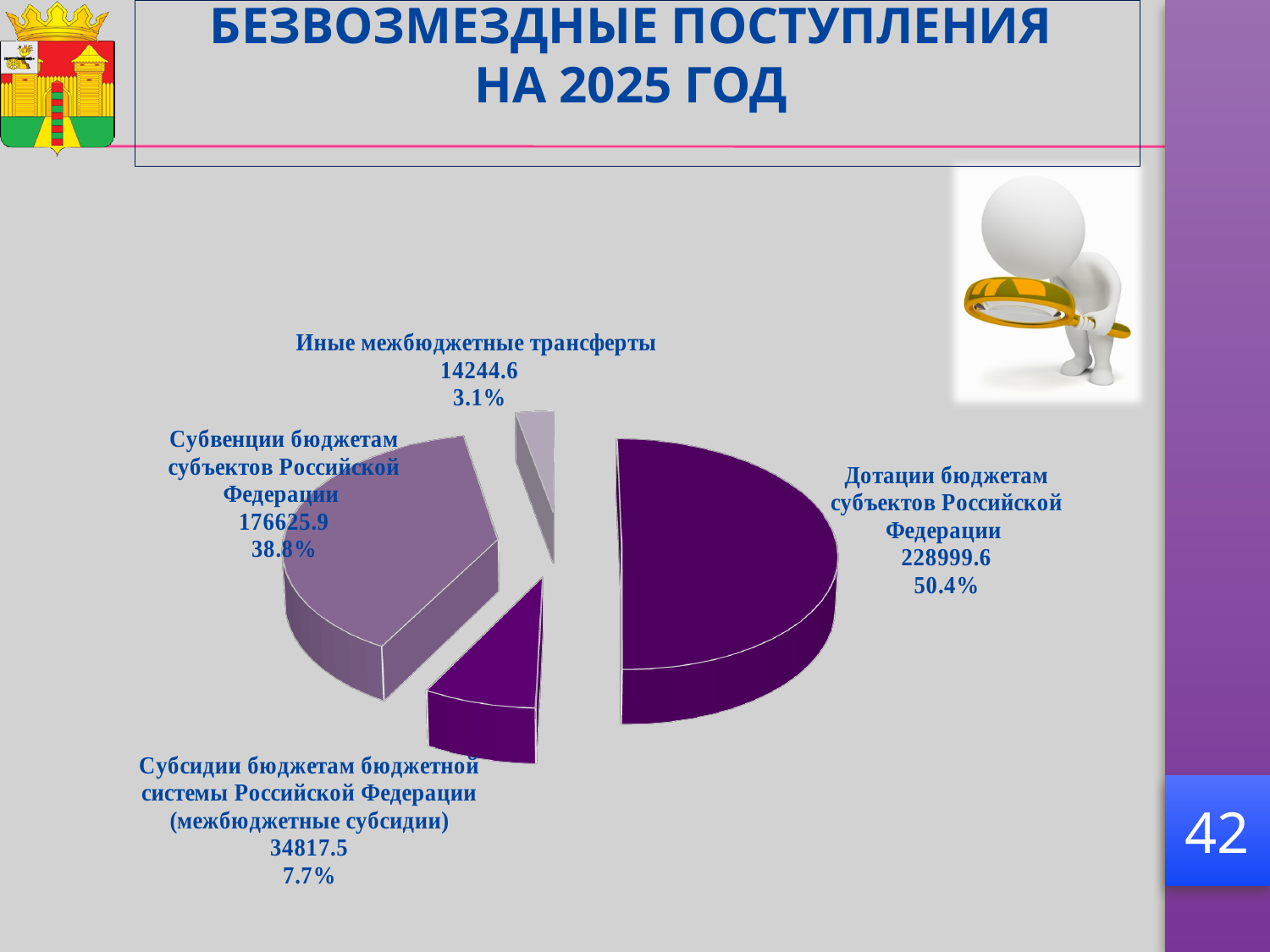
What is the title of the slide containing the pie chart? БЕЗВОЗМЕЗДНЫЕ ПОСТУПЛЕНИЯ НА 2025 ГОД What is the difference between the values for Дотации бюджетам субъектов Российской Федерации and Субвенции бюджетам субъектов Российской Федерации? 52373.7 Which category has the largest slice of the pie? Дотации бюджетам субъектов Российской Федерации What share of the pie does Субсидии бюджетам бюджетной системы Российской Федерации (межбюджетные субсидии) represent? 7.7% What is the value shown for Иные межбюджетные трансферты? 14244.6 What is the value shown for Субвенции бюджетам субъектов Российской Федерации? 176625.9 Which category has the smallest slice of the pie? Иные межбюджетные трансферты What is the value shown for Дотации бюджетам субъектов Российской Федерации? 228999.6 How many slices does the pie chart have? 4 What share of the pie does Дотации бюджетам субъектов Российской Федерации represent? 50.4% Which is larger: the value for Субсидии бюджетам бюджетной системы Российской Федерации (межбюджетные субсидии) or the value for Иные межбюджетные трансферты? Субсидии бюджетам бюджетной системы Российской Федерации (межбюджетные субсидии) What kind of chart is shown on the slide? pie chart